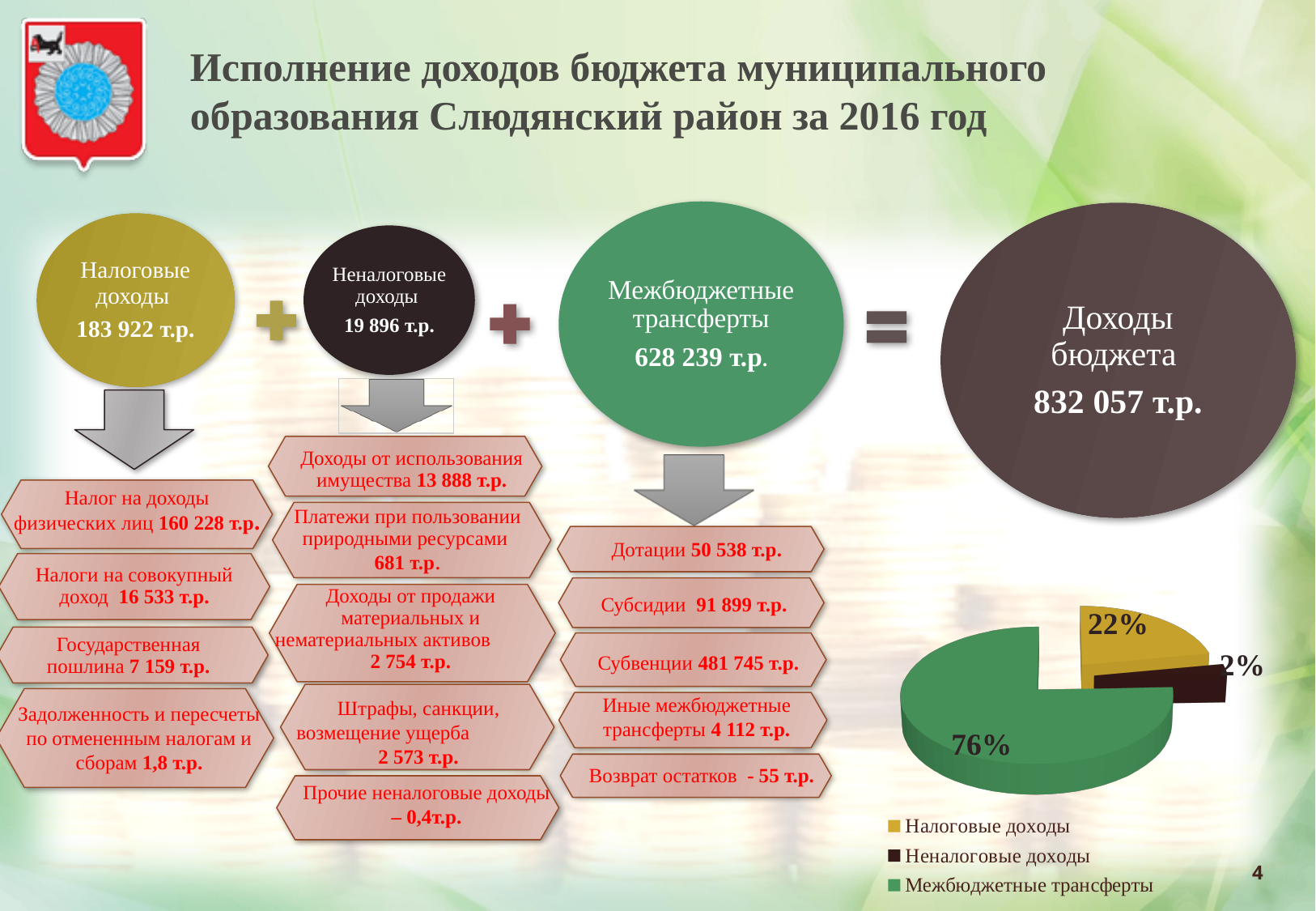
In the pie chart, what share is shown for Межбюджетные трансферты? 76% What colour is the Межбюджетные трансферты slice in the pie chart? green By how many percentage points does the share of Межбюджетные трансферты exceed the share of Налоговые доходы in the pie chart? 54 Which slice of the pie chart is the largest? Межбюджетные трансферты In the pie chart, what share is shown for Налоговые доходы? 22% In the pie chart, which is larger: the share of Налоговые доходы or the share of Неналоговые доходы? Налоговые доходы By how many percentage points does the share of Налоговые доходы exceed the share of Неналоговые доходы in the pie chart? 20 Which slice of the pie chart is the smallest? Неналоговые доходы In the pie chart, what share is shown for Неналоговые доходы? 2% How many entries does the pie chart legend list? 3 What kind of chart is shown on the slide? pie chart How many slices does the pie chart have? 3